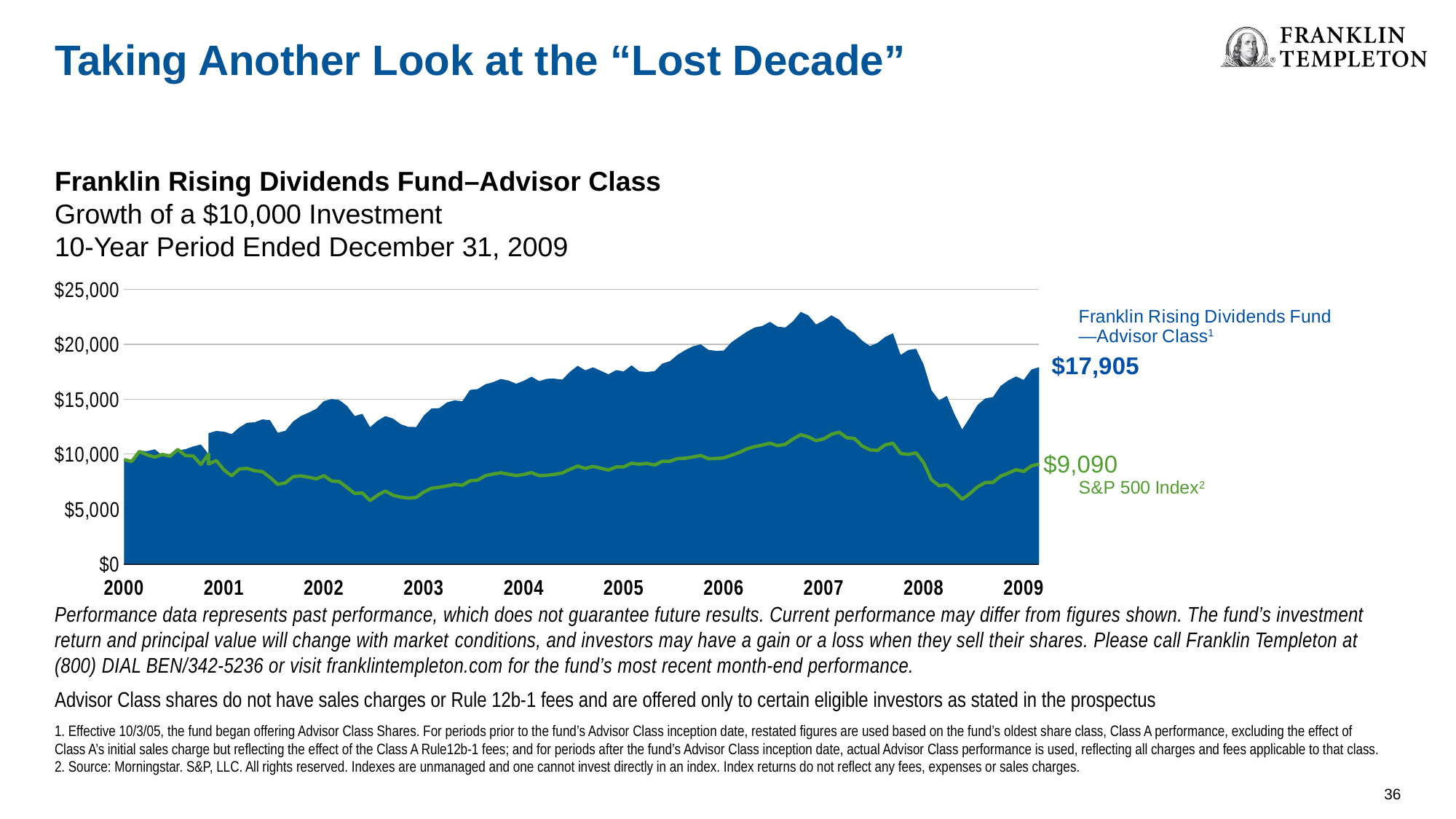
What is the ending value shown for the S&P 500 Index? $9,090 Which series ended the period with the higher value, the Franklin Rising Dividends Fund—Advisor Class or the S&P 500 Index? Franklin Rising Dividends Fund—Advisor Class How many years are labeled on the x axis of the chart? 10 Did the S&P 500 Index rise or fall between its 2007 peak and the end of 2008? fall Is the value of the Franklin Rising Dividends Fund—Advisor Class at the start of 2005 greater or less than $15,000? greater What is the ending value shown for the Franklin Rising Dividends Fund—Advisor Class? $17,905 What is the difference between the ending values of the Franklin Rising Dividends Fund—Advisor Class and the S&P 500 Index? $8,815 How many series are plotted on the chart? 2 What initial investment amount does the chart track the growth of? $10,000 Is the value of the S&P 500 Index at its low point in early 2009 greater or less than $10,000? less Did the Franklin Rising Dividends Fund—Advisor Class rise or fall from 2003 to 2007? rise Is the peak value of the Franklin Rising Dividends Fund—Advisor Class in 2007 greater or less than $20,000? greater